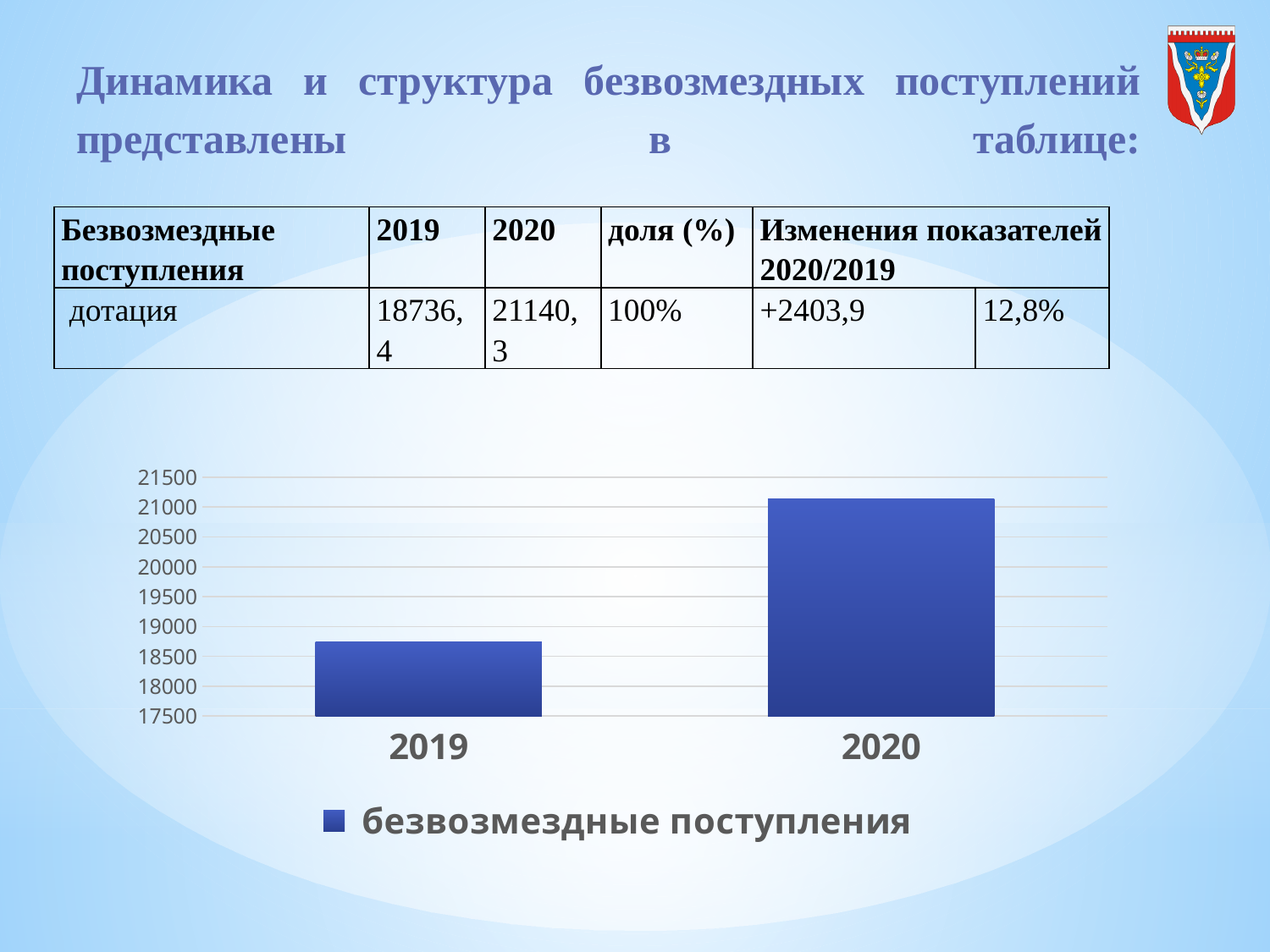
Which category has the lowest bar in the chart? 2019 Do the values in the chart rise or fall from 2019 to 2020? rise How many series does the chart legend list? 1 What is the name of the series shown in the chart legend? безвозмездные поступления What kind of chart is shown on the slide? bar chart Is the value for 2020 in the chart greater or less than 21000? greater Which category has the highest bar in the chart? 2020 Is the value for 2019 in the chart greater or less than 18500? greater Which year has the higher bar in the chart, 2019 or 2020? 2020 How many bars are plotted in the chart? 2 Is the value for 2019 in the chart greater or less than 19000? less